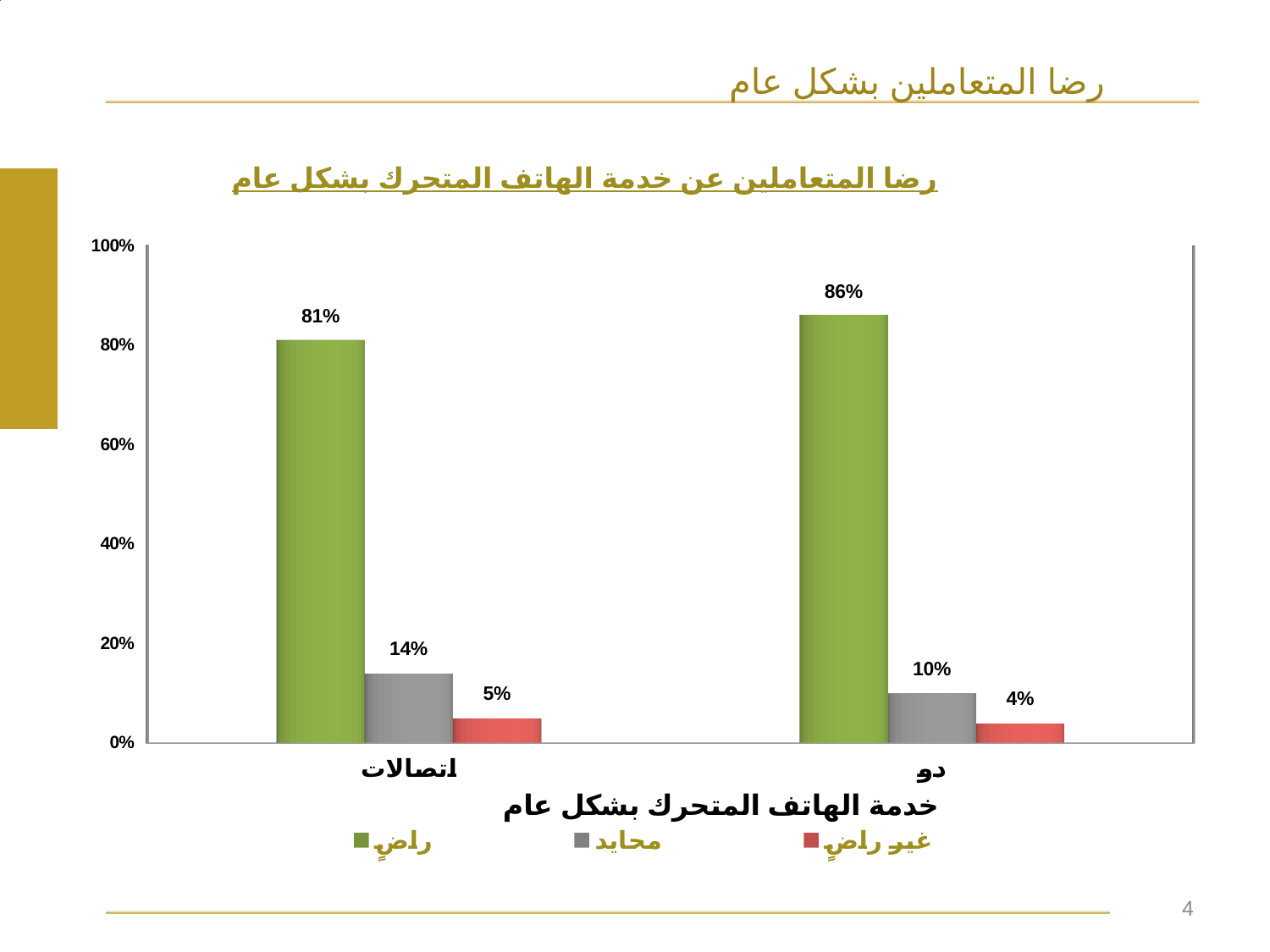
What is the difference between the راضٍ values for دو and اتصالات? 5% What kind of chart is shown on the slide? bar chart What is the value for راضٍ (satisfied) for دو? 86% Which category has the lowest value for غير راضٍ (not satisfied)? دو What is the value for راضٍ (satisfied) for اتصالات? 81% Which is larger: the محايد value for اتصالات or for دو? اتصالات What is the value for غير راضٍ (not satisfied) for دو? 4% How many categories are shown on the x axis? 2 How many series does the legend list? 3 What is the value for محايد (neutral) for اتصالات? 14% Which category has the higher value for راضٍ (satisfied)? دو Is the value for راضٍ for اتصالات greater or less than 80%? greater